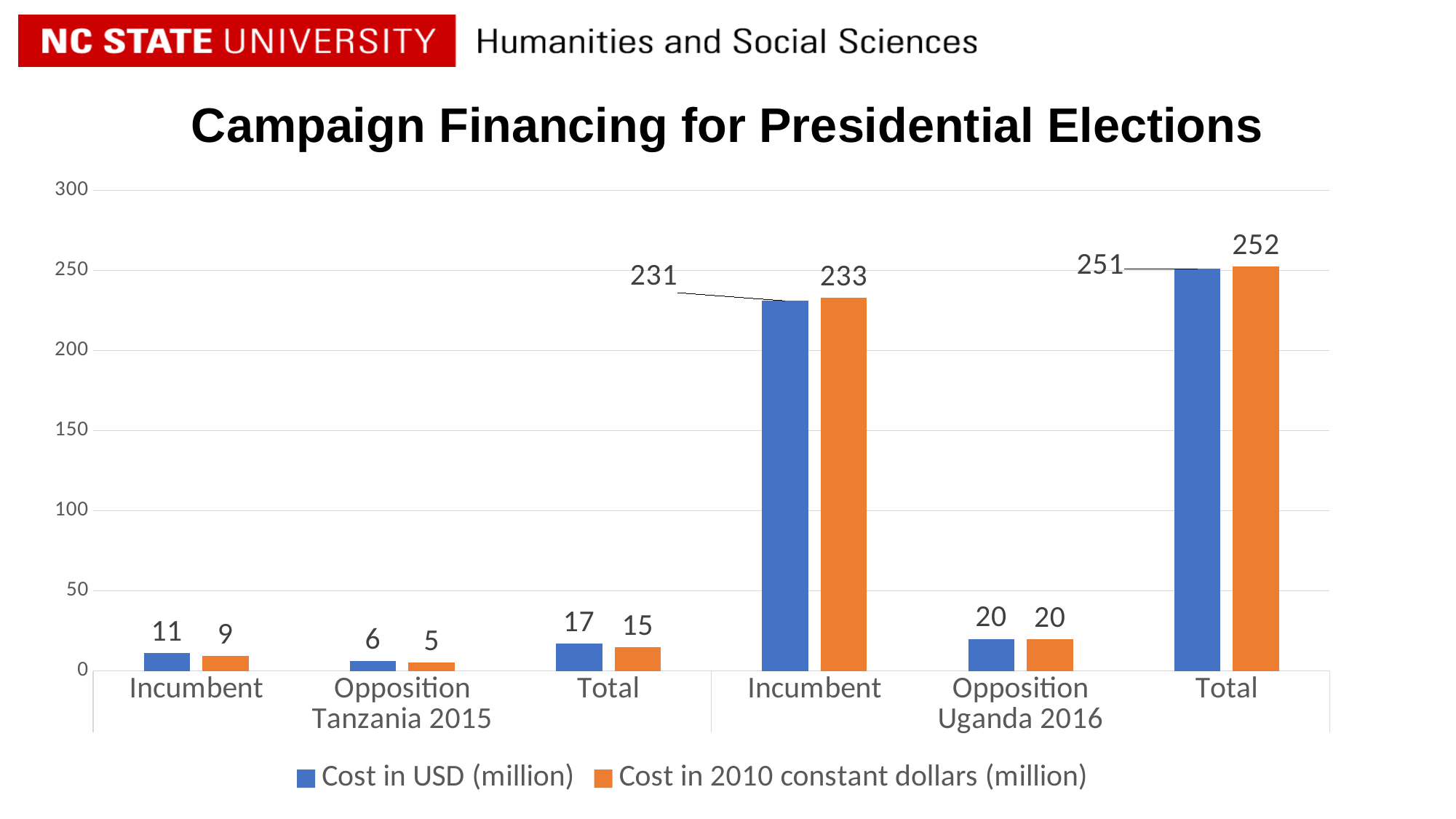
Which category has the highest Cost in 2010 constant dollars (million)? Total, Uganda 2016 How many series does the legend list? 2 What is the Cost in USD (million) for the Incumbent in Tanzania 2015? 11 Which category has the lowest Cost in USD (million)? Opposition, Tanzania 2015 Which is larger: the Cost in USD (million) for the Total in Tanzania 2015 or the Opposition in Uganda 2016? Opposition, Uganda 2016 What is the Cost in 2010 constant dollars (million) for the Opposition in Uganda 2016? 20 What is the Cost in 2010 constant dollars (million) for the Total in Tanzania 2015? 15 What kind of chart is shown on the slide? Bar chart What is the title of the chart? Campaign Financing for Presidential Elections What is the Cost in USD (million) for the Total in Uganda 2016? 251 Is the Cost in USD (million) for the Incumbent in Uganda 2016 greater or less than 200? greater What is the difference between the Cost in USD (million) for the Incumbent in Uganda 2016 and the Incumbent in Tanzania 2015? 220